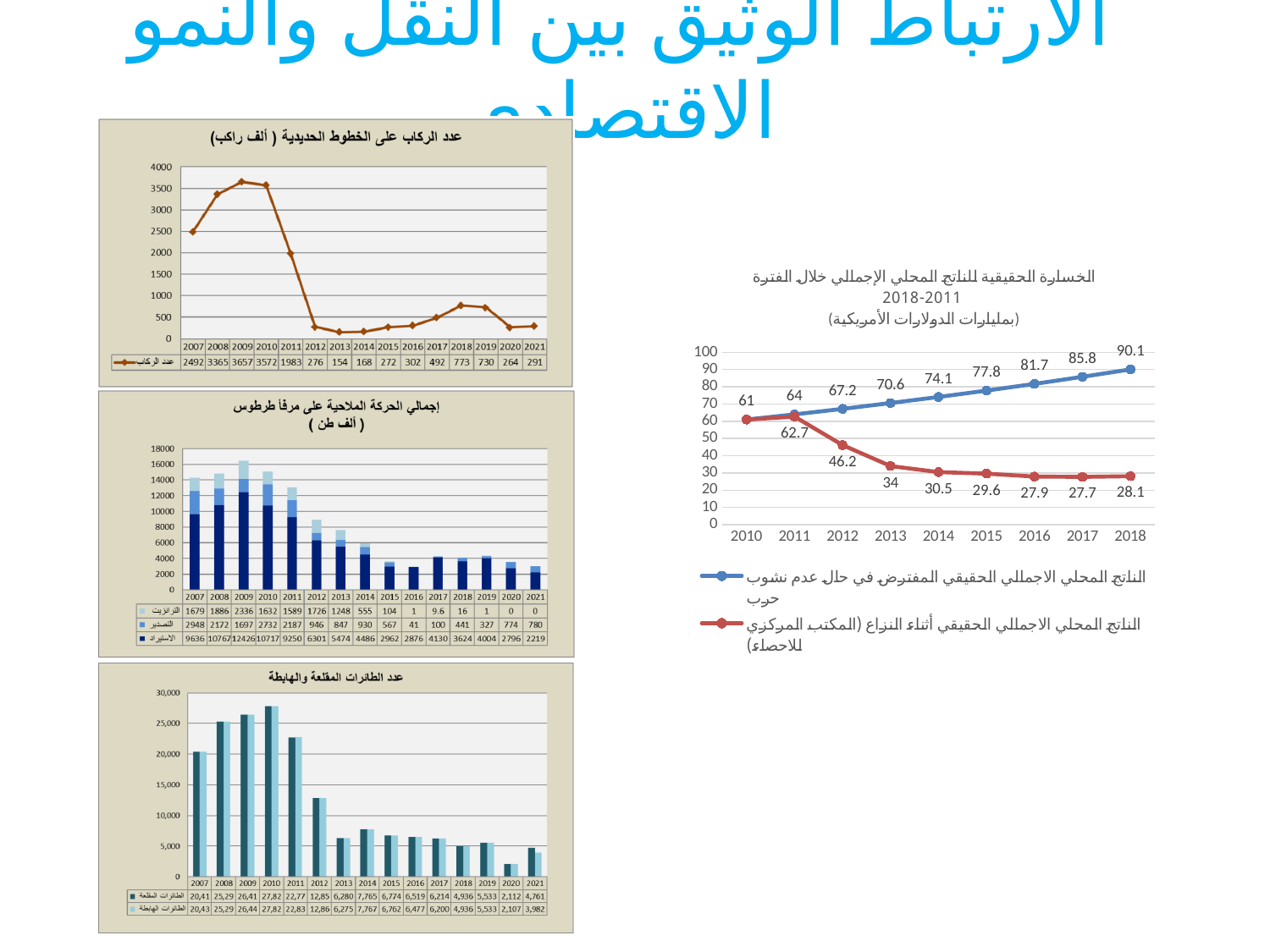
In the railway passengers chart at the top left, how many years are plotted? 15 In the GDP loss chart on the right, what is the value of the blue series (GDP assuming no war) for 2018? 90.1 In the railway passengers chart (عدد الركاب على الخطوط الحديدية) at the top left, what is the value for 2009? 3657 In the aircraft chart (عدد الطائرات المقلعة والهابطة) at the bottom left, what is the value of الطائرات المقلعة for 2014? 7,765 In the railway passengers chart at the top left, what is the difference between the values for 2011 and 2012? 1707 In the Tartous port traffic chart in the middle left, how many series does the legend list? 3 In the Tartous port traffic chart in the middle left, what is the value of الاستيراد for 2009? 12426 In the GDP loss chart on the right, does the red series (actual GDP during conflict) rise or fall from 2011 to 2017? Fall In the Tartous port traffic chart in the middle left, what is the total of the stacked bar for 2021? 2999 In the GDP loss chart on the right, what is the difference between the two series in 2016? 53.8 What type of chart is the Tartous port traffic chart (إجمالي الحركة الملاحية على مرفأ طرطوس) in the middle left? Stacked bar chart In the railway passengers chart at the top left, which year has the lowest number of passengers? 2013